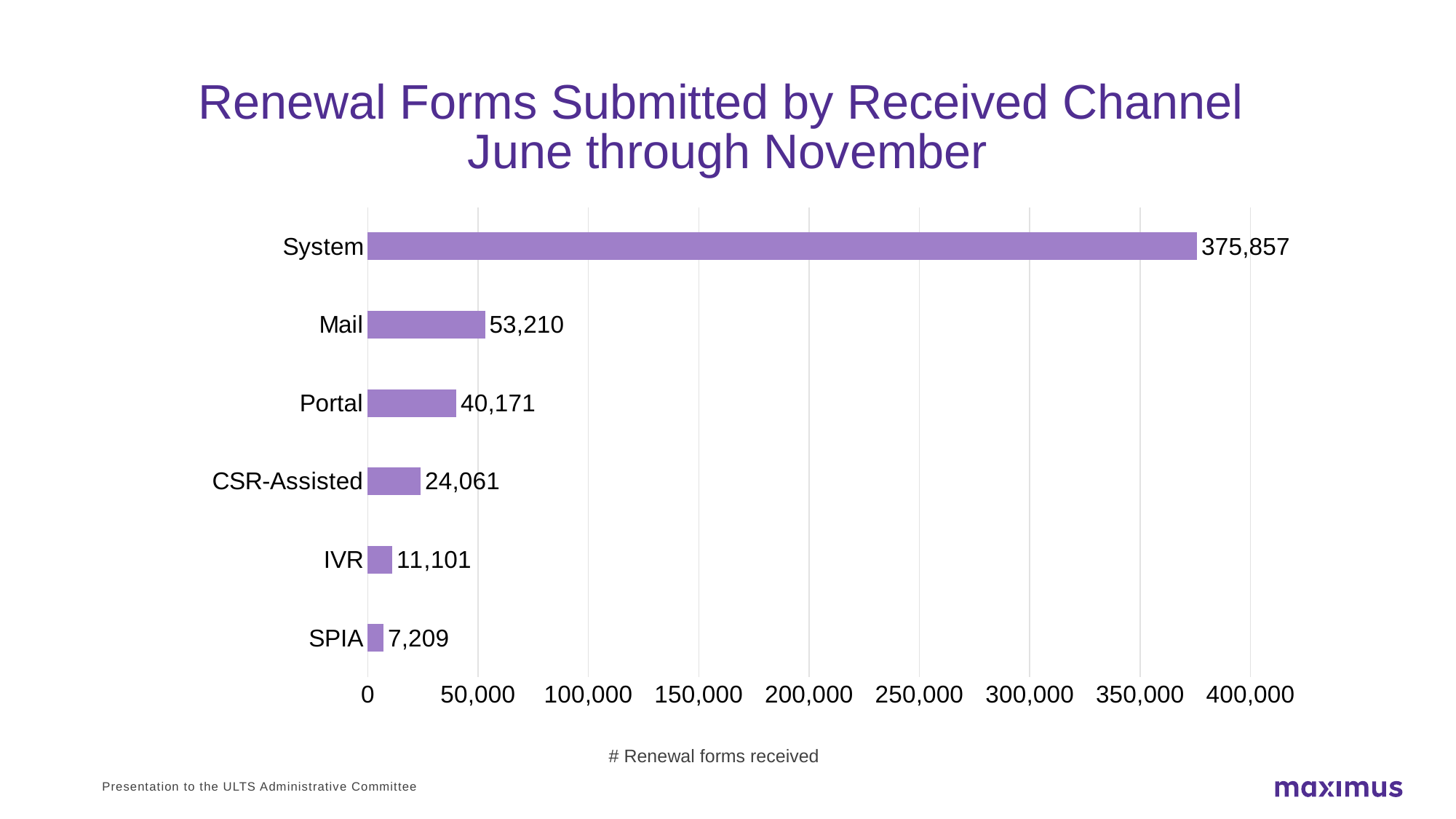
Which channel received the fewest renewal forms? SPIA What is the difference between the Mail and Portal values? 13,039 What is the label on the horizontal axis of the chart? # Renewal forms received How many channels are shown in the chart? 6 What is the difference between the CSR-Assisted and IVR values? 12,960 What kind of chart is shown on the slide? Bar chart What is the value shown for the Portal channel? 40,171 How many renewal forms were received via IVR? 11,101 Which channel has a larger value, Portal or CSR-Assisted? Portal Which channel received the most renewal forms? System How many renewal forms were received through the Mail channel? 53,210 Is the value for System greater or less than 350,000? greater